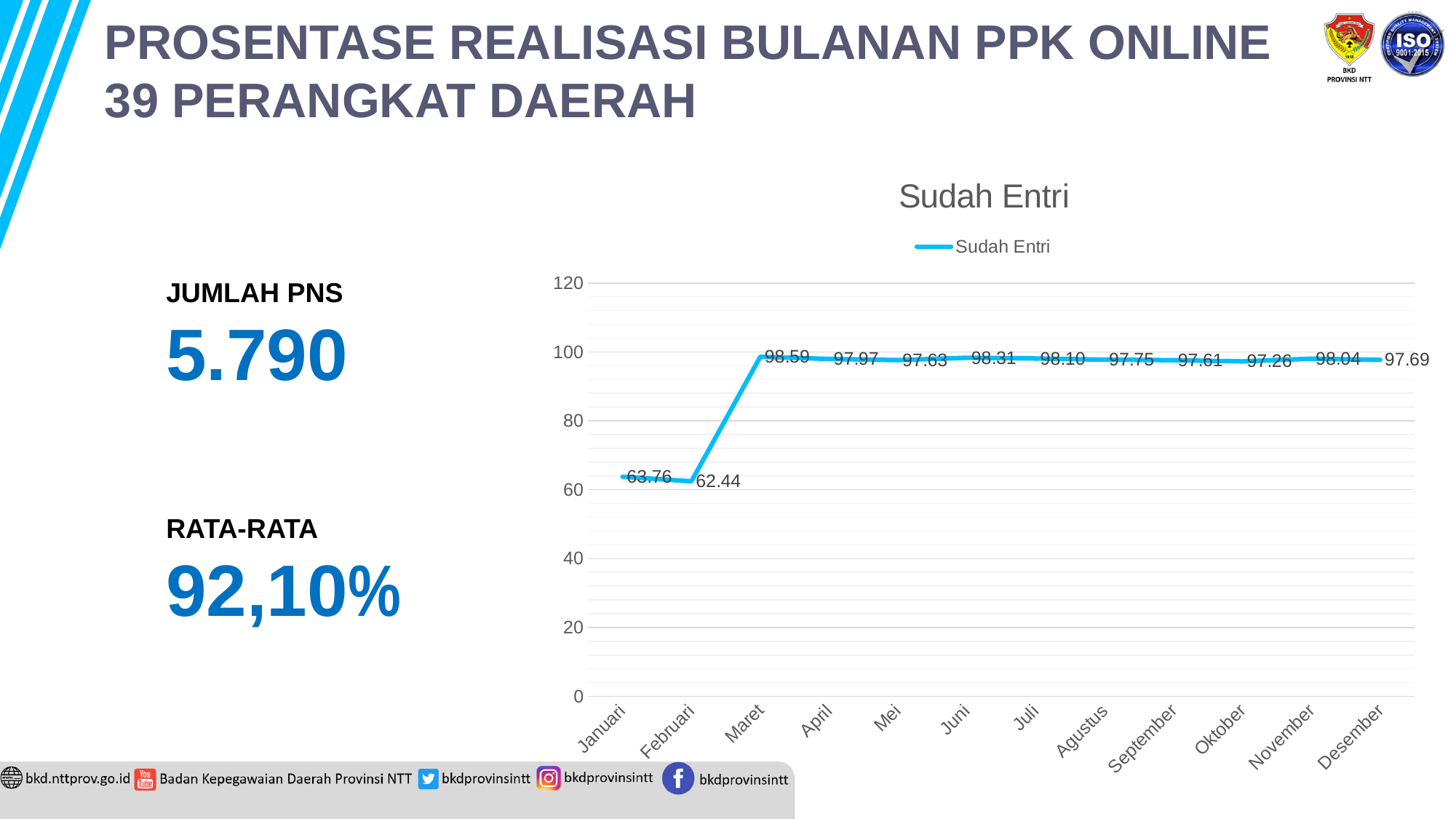
How many series does the legend of the Sudah Entri chart list? 1 What is the value for Oktober in the Sudah Entri chart? 97.26 What kind of chart is the Sudah Entri chart? line chart What is the title of the chart on the slide? Sudah Entri Which month has the highest value in the Sudah Entri chart? Maret What is the value for Maret in the Sudah Entri chart? 98.59 What is the value for Februari in the Sudah Entri chart? 62.44 How many months are plotted on the x axis of the Sudah Entri chart? 12 Which month has the lowest value in the Sudah Entri chart? Februari Which is larger in the Sudah Entri chart, the value for Januari or the value for Februari? Januari Is the value for Desember in the Sudah Entri chart greater or less than 80? greater What is the difference between the values for Maret and Februari in the Sudah Entri chart? 36.15